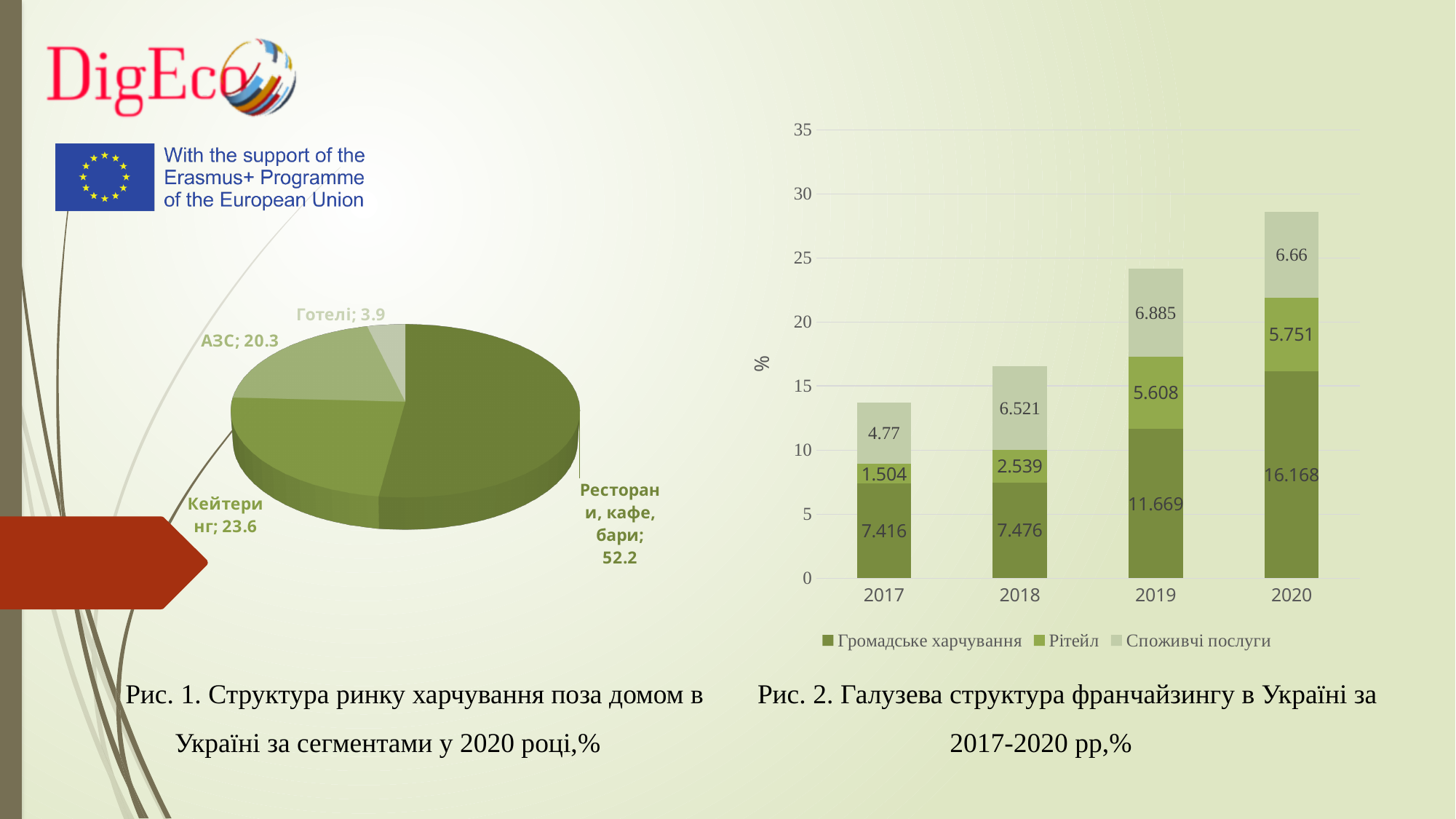
In the stacked bar chart (Рис. 2), what is the value for Громадське харчування in 2019? 11.669 What kind of chart is Рис. 2? stacked bar chart In the pie chart (Рис. 1), which segment has the largest share? Ресторани, кафе, бари In the pie chart (Рис. 1), how many segments are shown? 4 In the stacked bar chart (Рис. 2), how many series does the legend list? 3 In the stacked bar chart (Рис. 2), does the value for Громадське харчування rise or fall from 2017 to 2020? rise In the stacked bar chart (Рис. 2), what is the total of the stacked bar for 2017? 13.69 In the pie chart (Рис. 1), what is the value for Кейтеринг? 23.6 In the stacked bar chart (Рис. 2), what is the value for Рітейл in 2018? 2.539 In the pie chart (Рис. 1), what is the difference between the values for АЗС and Готелі? 16.4 In the stacked bar chart (Рис. 2), which is larger: Споживчі послуги in 2019 or Споживчі послуги in 2020? 2019 In the pie chart (Рис. 1), which segment has the smallest share? Готелі